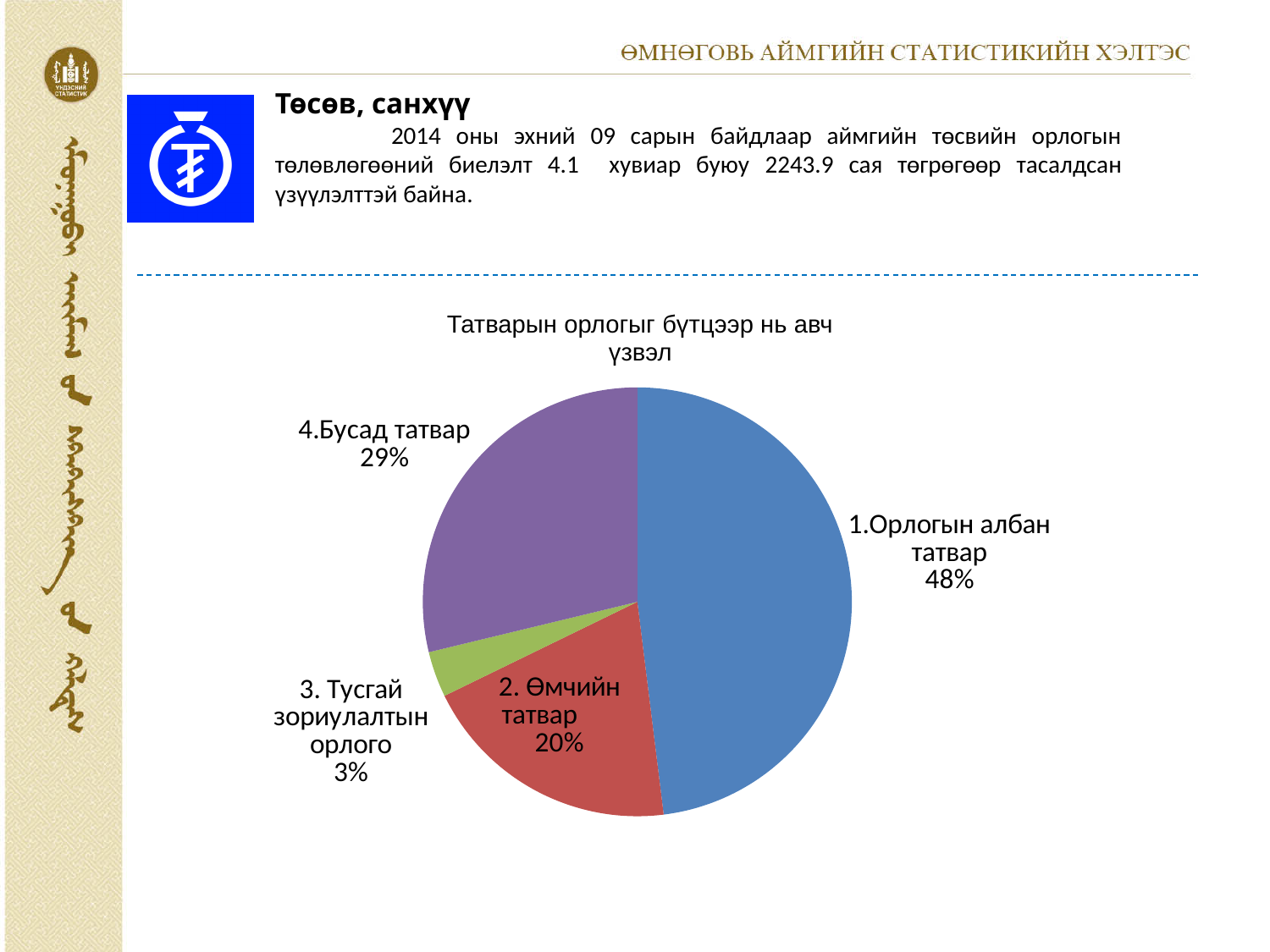
Which category has the largest share of the pie? 1.Орлогын албан татвар What share of the pie does '3. Тусгай зориулалтын орлого' have? 3% Which is larger, the share for '2. Өмчийн татвар' or the share for '4.Бусад татвар'? 4.Бусад татвар How many slices does the pie chart have? 4 Which category has the smallest share of the pie? 3. Тусгай зориулалтын орлого What kind of chart is shown on the slide? pie chart What share of the pie does '2. Өмчийн татвар' have? 20% What colour is the slice for '1.Орлогын албан татвар'? blue What share of the pie does '4.Бусад татвар' have? 29% What is the difference in percentage points between '1.Орлогын албан татвар' and '4.Бусад татвар'? 19 What is the title of the chart? Татварын орлогыг бүтцээр нь авч үзвэл